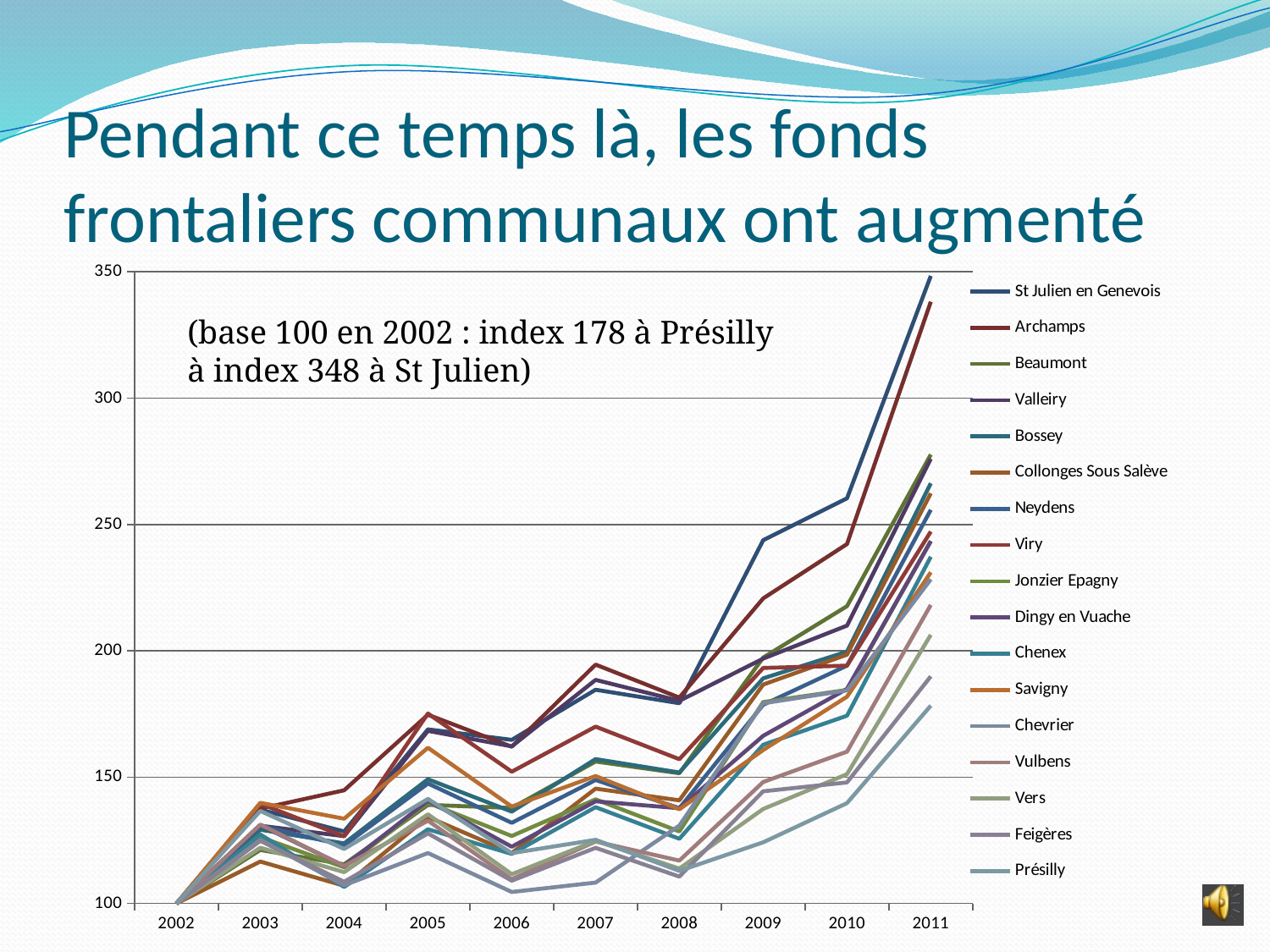
What is the index value for St Julien en Genevois in 2011? 348 How many series does the legend list? 17 How many years are shown along the x axis? 10 Does the index for St Julien en Genevois rise or fall overall from 2002 to 2011? rise What is the difference between the 2011 index of St Julien en Genevois and that of Présilly? 170 Which commune is listed first in the legend? St Julien en Genevois What is the index value of every commune in 2002? 100 Which commune has the lowest index in 2011? Présilly What is the index value for Présilly in 2011? 178 Is the value for Archamps in 2011 greater or less than 300? greater What kind of chart is shown on the slide? line chart Which commune has the highest index in 2011? St Julien en Genevois